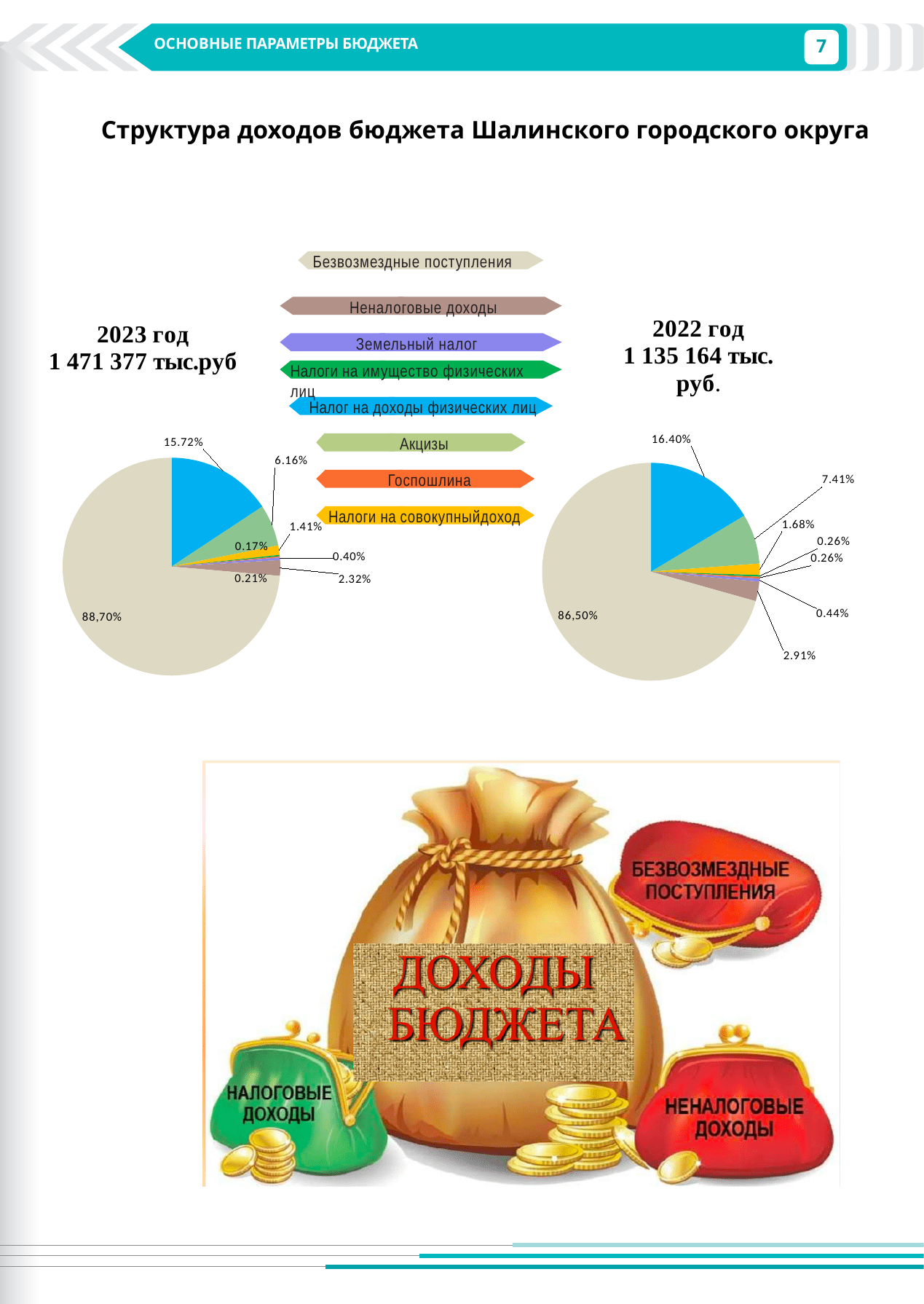
In the 2023 год pie chart, what share is labelled for the largest slice (Безвозмездные поступления)? 88,70% In the 2023 год pie chart, what share is shown for Налог на доходы физических лиц (the blue slice)? 15.72% In the 2023 год pie chart, which category has the largest share? Безвозмездные поступления What is the difference between the Налог на доходы физических лиц share in 2022 год (16.40%) and in 2023 год (15.72%)? 0.68% What kind of chart is used to show the 2023 год revenue structure? Pie chart Which year shows a larger share for Налог на доходы физических лиц, 2023 год or 2022 год? 2022 год In the 2022 год pie chart, what share is labelled for the largest slice (Безвозмездные поступления)? 86,50% In the 2022 год pie chart, what share is shown for Налог на доходы физических лиц (the blue slice)? 16.40% In the 2023 год pie chart, what share is shown for Акцизы (the light green slice)? 6.16% What total revenue amount is stated above the 2023 год pie chart? 1 471 377 тыс.руб In the 2022 год pie chart, what share is shown for Акцизы (the light green slice)? 7.41% How many categories does the shared legend between the two pie charts list? 8